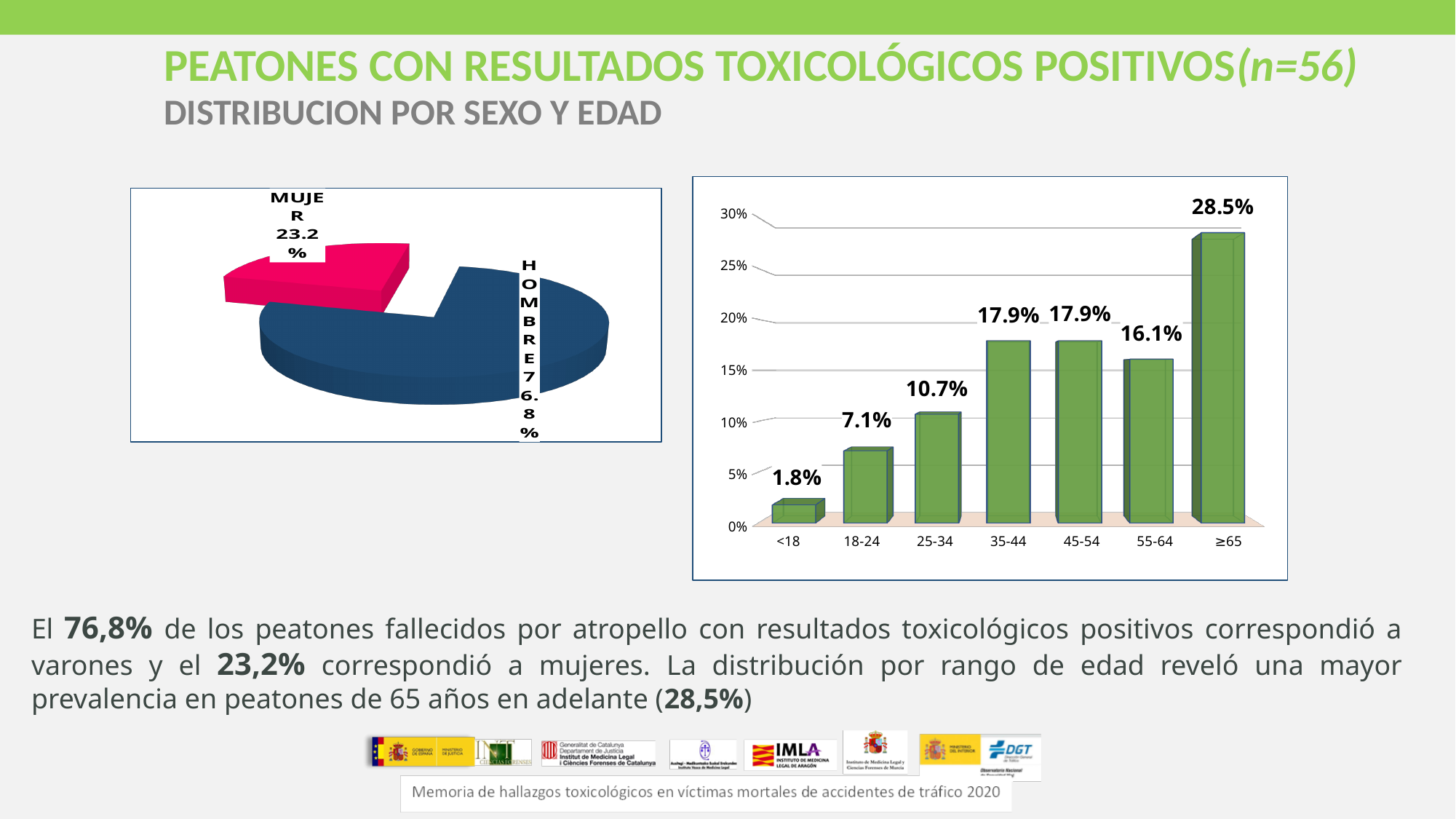
In the pie chart on the left, what share does the HOMBRE slice represent? 76.8% In the bar chart on the right, which age group has the highest value? ≥65 In the bar chart on the right, how many age groups are shown on the x axis? 7 In the bar chart on the right, which is larger, the value for 25-34 or the value for 55-64? 55-64 In the bar chart on the right, what is the value for the 18-24 age group? 7.1% What kind of chart is the chart on the left? pie chart In the bar chart on the right, what is the value for the ≥65 age group? 28.5% In the bar chart on the right, which age group has the lowest value? <18 In the bar chart on the right, do the values generally rise or fall from <18 to ≥65? rise In the bar chart on the right, what is the difference between the values for ≥65 and 55-64? 12.4% In the pie chart on the left, what colour is the MUJER slice? pink In the pie chart on the left, what share does the MUJER slice represent? 23.2%